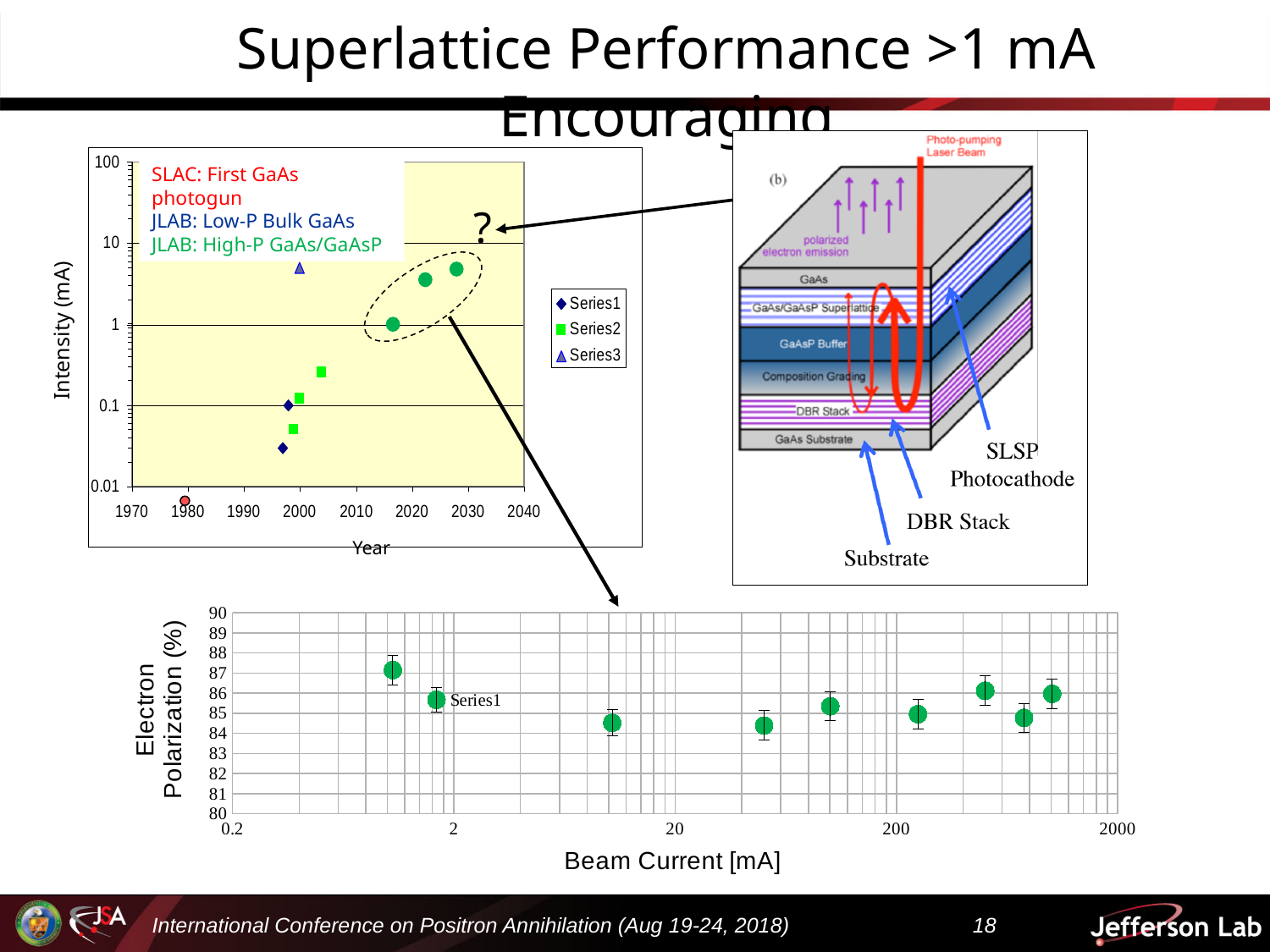
In the top-left chart, are the Series1 points greater or less than 1 mA? less In the bottom Electron Polarization chart, is the value of the leftmost point (near 1 mA) greater or less than 86%? greater In the top-left chart, what is the last year shown on the x axis? 2040 In the top-left chart, what is the label of the y axis? Intensity (mA) In the top-left chart, is the value for the Series3 point greater or less than 1 mA? greater In the top-left chart, how many Series1 (diamond) points are plotted? 2 In the bottom Electron Polarization chart, how many series does the legend list? 1 In the bottom Electron Polarization chart, which point has the highest polarization: the leftmost point near 1 mA or the point near 30 mA? the leftmost point near 1 mA What kind of chart is the top-left chart of Intensity versus Year? scatter chart What kind of chart is the bottom chart of Electron Polarization versus Beam Current? scatter chart In the top-left Intensity versus Year chart, how many series does the legend list? 3